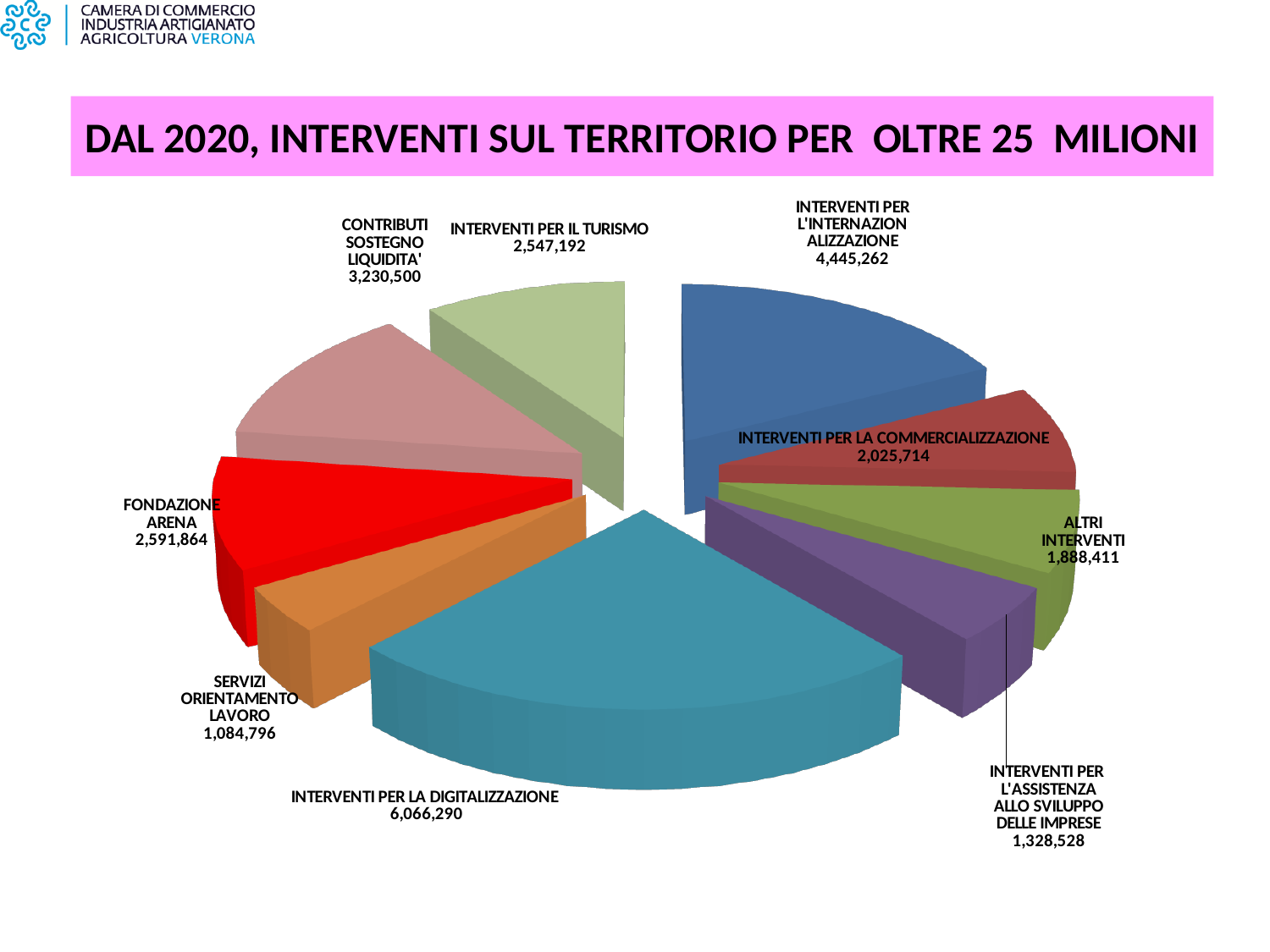
What is the value for SERVIZI ORIENTAMENTO LAVORO? 1,084,796 What is the value for INTERVENTI PER LA DIGITALIZZAZIONE? 6,066,290 What kind of chart is shown on the slide? Pie chart Which is larger, FONDAZIONE ARENA or INTERVENTI PER IL TURISMO? FONDAZIONE ARENA What is the value for INTERVENTI PER L'INTERNAZIONALIZZAZIONE? 4,445,262 Which category has the largest value? INTERVENTI PER LA DIGITALIZZAZIONE What is the value for INTERVENTI PER L'ASSISTENZA ALLO SVILUPPO DELLE IMPRESE? 1,328,528 Which category has the smallest value? SERVIZI ORIENTAMENTO LAVORO What is the title of the slide? DAL 2020, INTERVENTI SUL TERRITORIO PER OLTRE 25 MILIONI What is the value for CONTRIBUTI SOSTEGNO LIQUIDITA'? 3,230,500 What is the difference between INTERVENTI PER LA DIGITALIZZAZIONE and INTERVENTI PER L'INTERNAZIONALIZZAZIONE? 1,621,028 How many slices does the pie chart have? 9